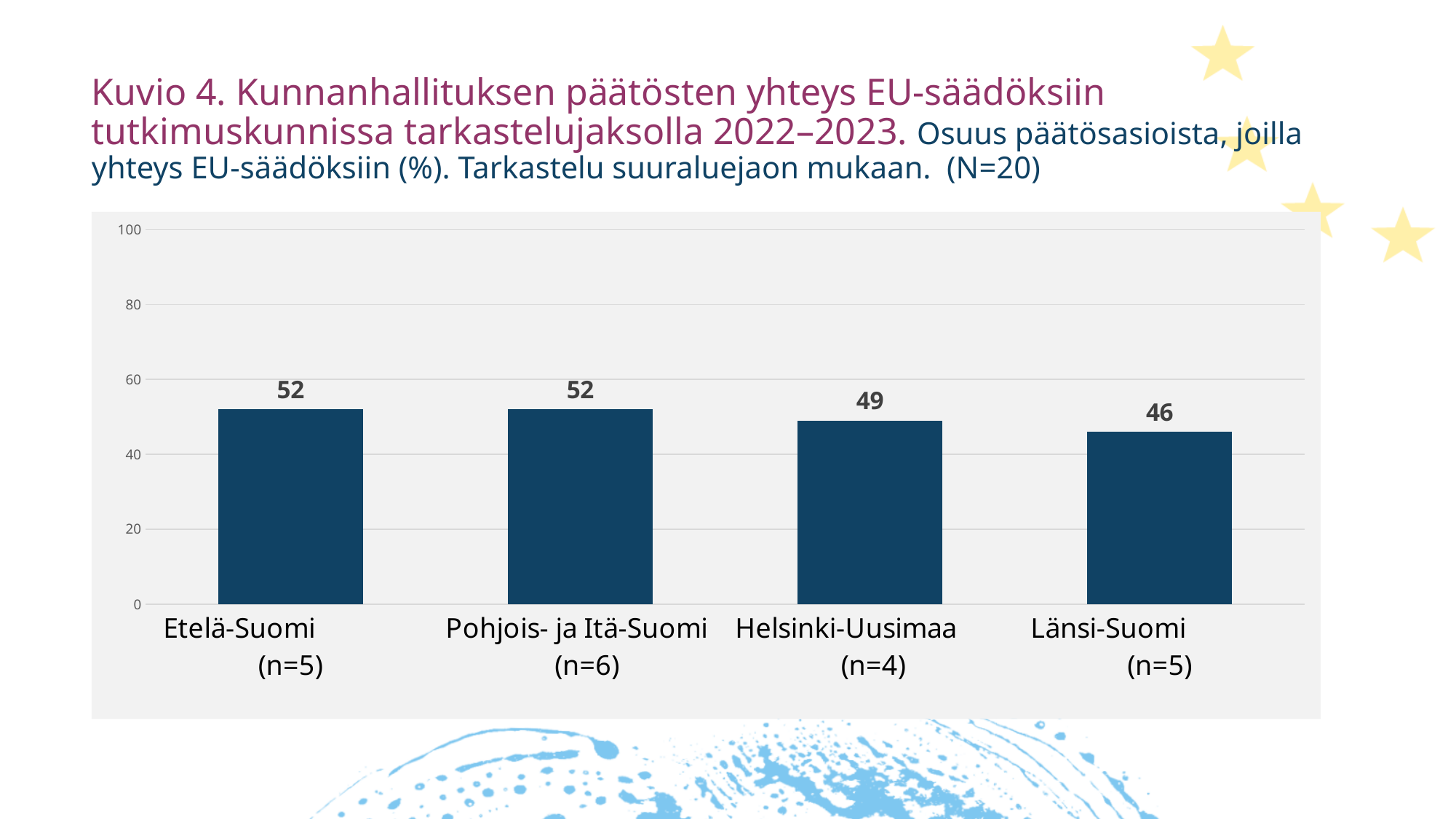
What is the difference between the values for Etelä-Suomi and Länsi-Suomi? 6 Which category has the lowest value? Länsi-Suomi (n=5) Is the value for Länsi-Suomi greater or less than 60? less What is the highest value shown on the y axis? 100 What is the value for Pohjois- ja Itä-Suomi (n=6)? 52 What is the difference between the values for Helsinki-Uusimaa and Länsi-Suomi? 3 What is the value for Länsi-Suomi (n=5)? 46 Which is larger, the value for Helsinki-Uusimaa or the value for Länsi-Suomi? Helsinki-Uusimaa What is the value for Helsinki-Uusimaa (n=4)? 49 How many categories are shown on the x axis? 4 What is the value for Etelä-Suomi (n=5)? 52 What kind of chart is shown on the slide? bar chart